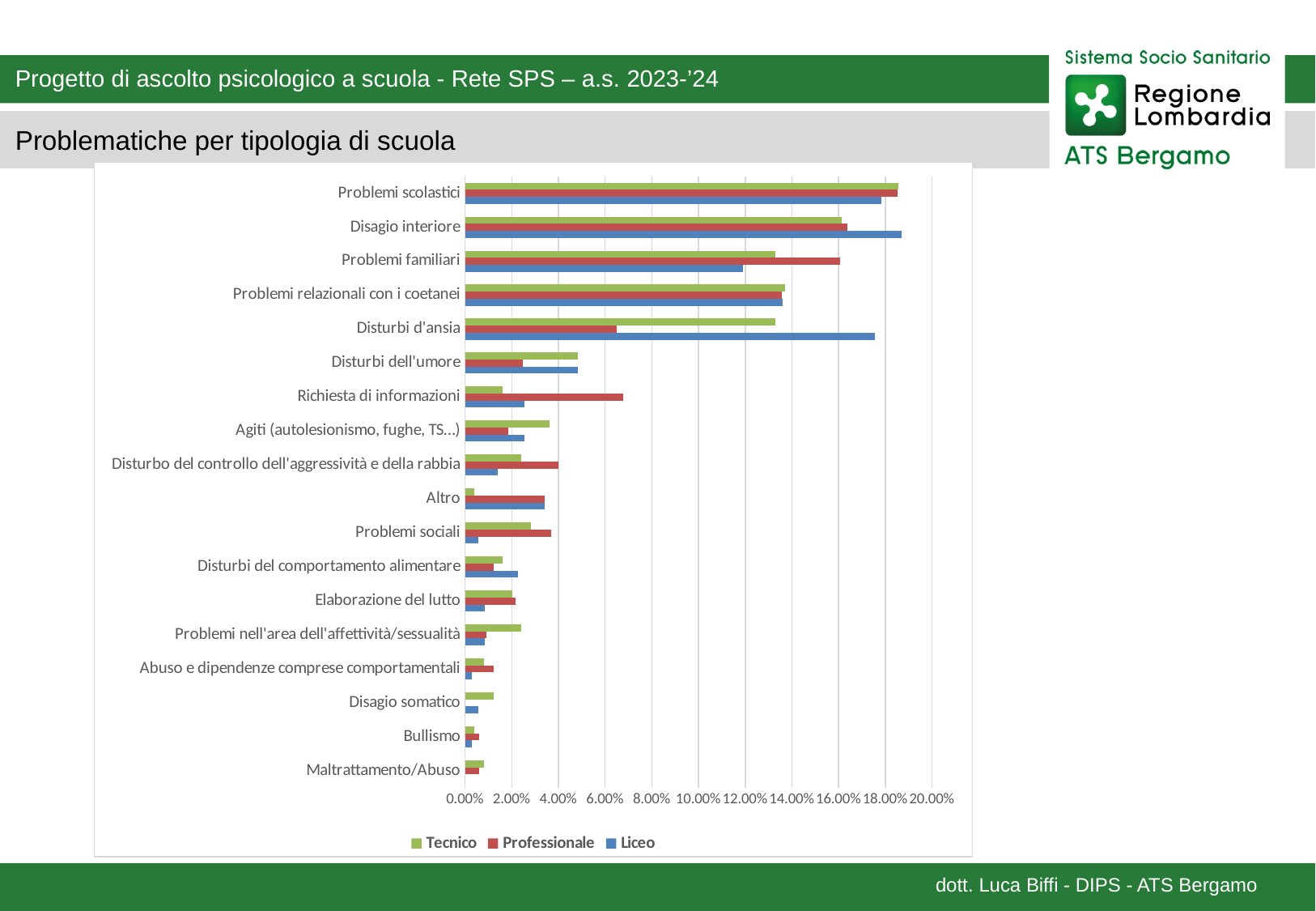
Which category has the highest Professionale value? Problemi scolastici For Disturbi d'ansia, which series has the larger value: Liceo or Professionale? Liceo Is the Professionale value for Disturbi d'ansia greater or less than 8.00%? less Is the Professionale value for Richiesta di informazioni greater or less than 4.00%? greater Is the Liceo value for Problemi familiari greater or less than 14.00%? less What colour represents the Liceo series in the legend? blue How many series does the legend list? 3 How many categories (problem types) are plotted on the chart? 18 What kind of chart is shown on the slide? bar chart For Problemi familiari, which series has the larger value: Professionale or Liceo? Professionale Which category has the highest Liceo value? Disagio interiore